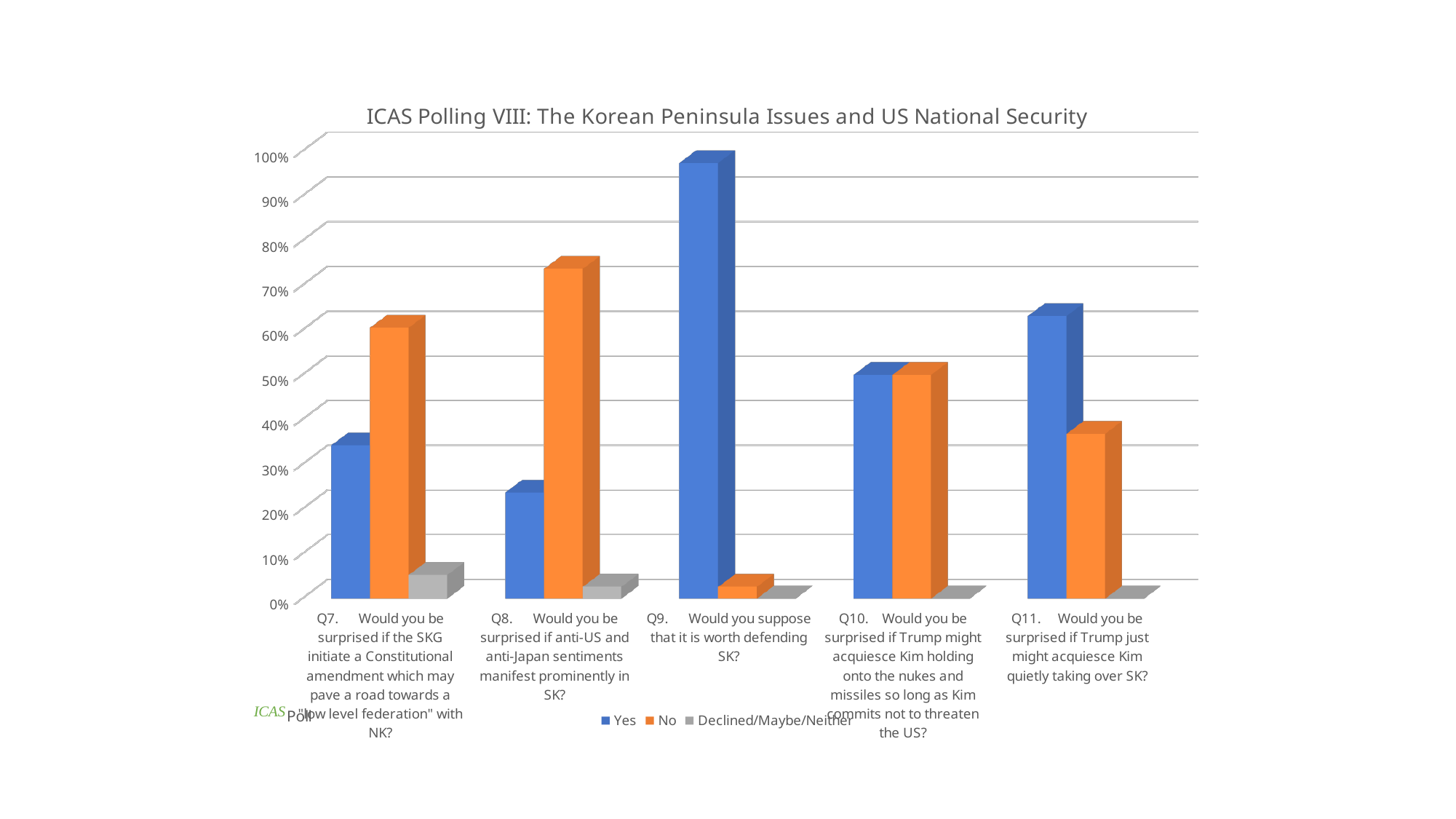
How many series does the legend list? 3 What is the title of the chart? ICAS Polling VIII: The Korean Peninsula Issues and US National Security Is the "Yes" value for Q9 greater or less than 90%? greater Which poll question has the highest "Yes" value? Q9. Would you suppose that it is worth defending SK? How many poll questions (categories) are shown on the x axis? 5 For Q11, which is larger, the "Yes" value or the "No" value? Yes Which poll question has the highest "No" value? Q8. Would you be surprised if anti-US and anti-Japan sentiments manifest prominently in SK? For Q7, which is larger, the "Yes" value or the "No" value? No Is the "Yes" value for Q7 greater or less than 40%? less Which poll question has the lowest "Yes" value? Q8. Would you be surprised if anti-US and anti-Japan sentiments manifest prominently in SK? What kind of chart is shown on the slide? bar chart Is the "No" value for Q8 greater or less than 60%? greater